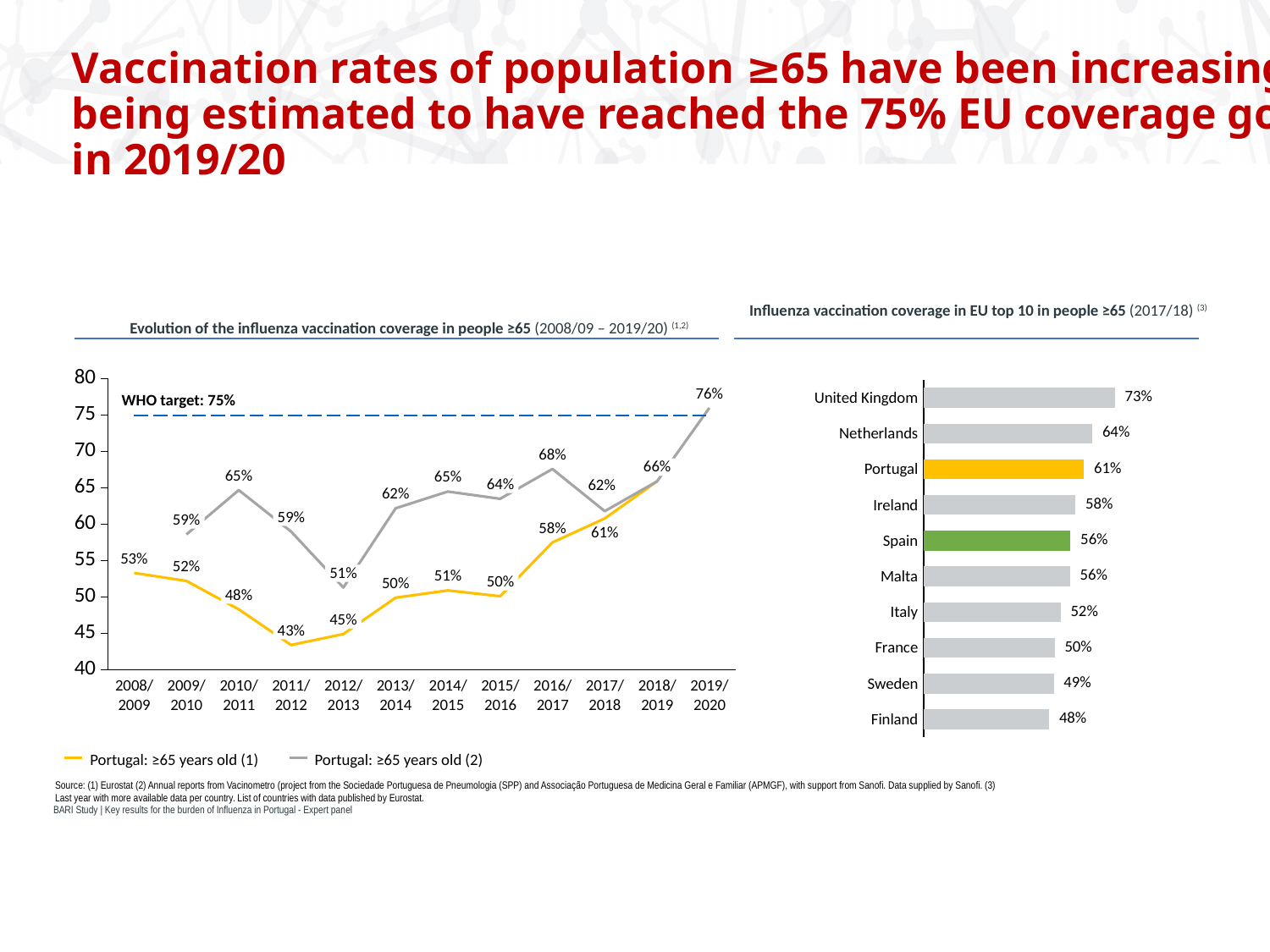
What kind of chart is the 'Influenza vaccination coverage in EU top 10' chart? Bar chart In the 'Evolution of the influenza vaccination coverage' line chart, what WHO target is marked by the dashed line? 75% In the 'Evolution of the influenza vaccination coverage' line chart, what is the value of the 'Portugal: ≥65 years old (2)' series in 2019/2020? 76% In the 'Influenza vaccination coverage in EU top 10' bar chart, what is the difference between the United Kingdom and the Netherlands? 9% In the 'Evolution of the influenza vaccination coverage' line chart, which is larger in 2013/2014: the 'Portugal: ≥65 years old (1)' series or the 'Portugal: ≥65 years old (2)' series? Portugal: ≥65 years old (2) In the 'Influenza vaccination coverage in EU top 10' bar chart, which country has the highest coverage? United Kingdom In the 'Influenza vaccination coverage in EU top 10' bar chart, what is the value for Portugal? 61% In the 'Influenza vaccination coverage in EU top 10' bar chart, which country has the lowest coverage? Finland In the 'Influenza vaccination coverage in EU top 10' bar chart, how many countries are shown? 10 How many series does the legend of the 'Evolution of the influenza vaccination coverage' line chart list? 2 In the 'Evolution of the influenza vaccination coverage' line chart, what is the difference between the two series in 2016/2017? 10% In the 'Evolution of the influenza vaccination coverage' line chart, what is the value of the 'Portugal: ≥65 years old (1)' series in 2011/2012? 43%